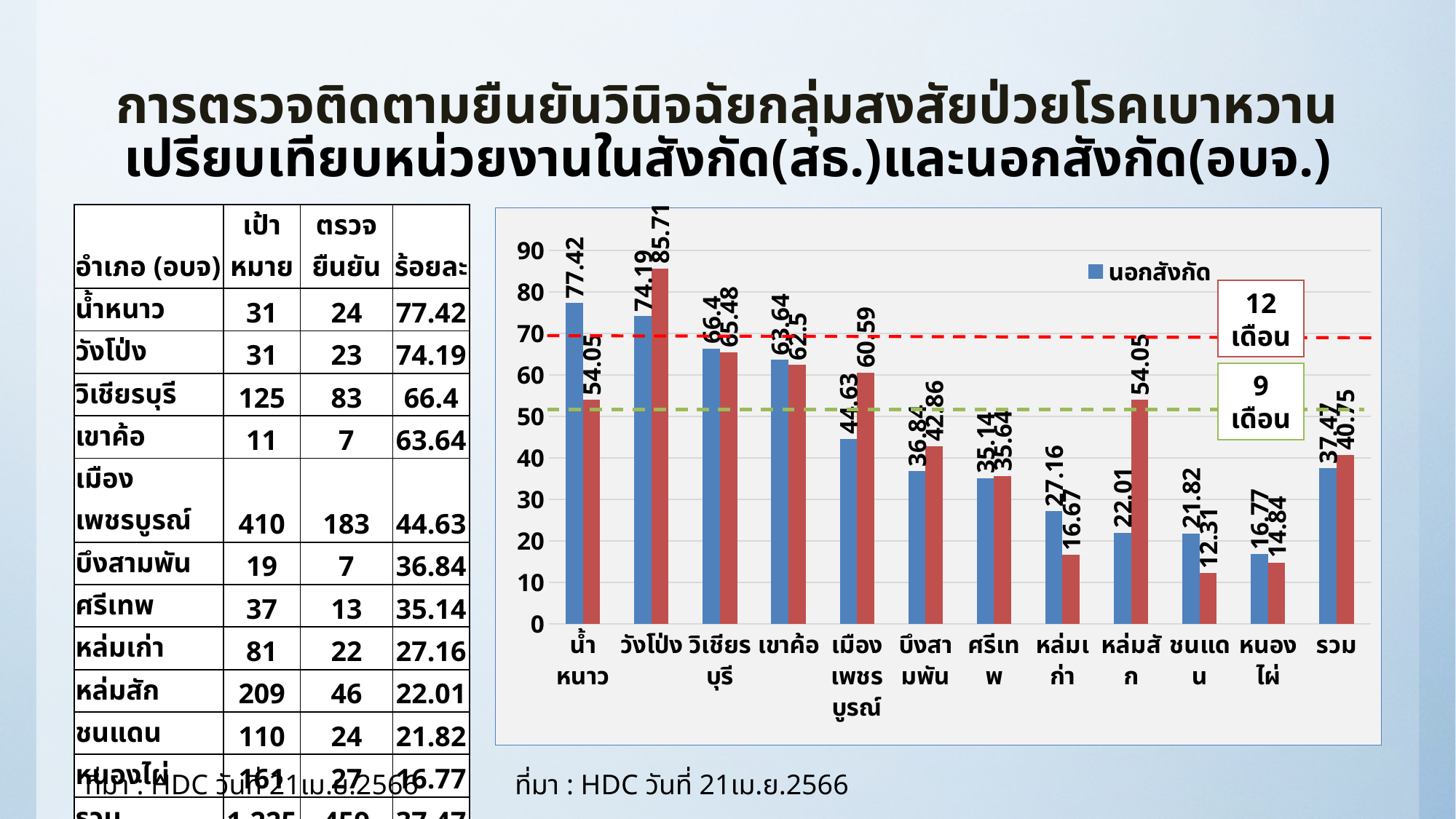
What is the difference between the blue and red bars for หล่มสัก? 32.04 For เมืองเพชรบูรณ์, which bar is larger, the blue or the red? red Which category has the highest นอกสังกัด (blue) value? น้ำหนาว What labels are attached to the two dashed horizontal reference lines on the chart? 12 เดือน and 9 เดือน What is the นอกสังกัด (blue) value for หล่มสัก? 22.01 Is the นอกสังกัด (blue) value for ชนแดน greater or less than 30? less What type of chart is shown on the slide? bar chart Which category has the lowest นอกสังกัด (blue) value? หนองไผ่ What is the นอกสังกัด (blue) value for น้ำหนาว? 77.42 What is the red bar value for วังโป่ง? 85.71 What series name is shown in the chart legend? นอกสังกัด How many categories are shown on the x axis of the chart? 12